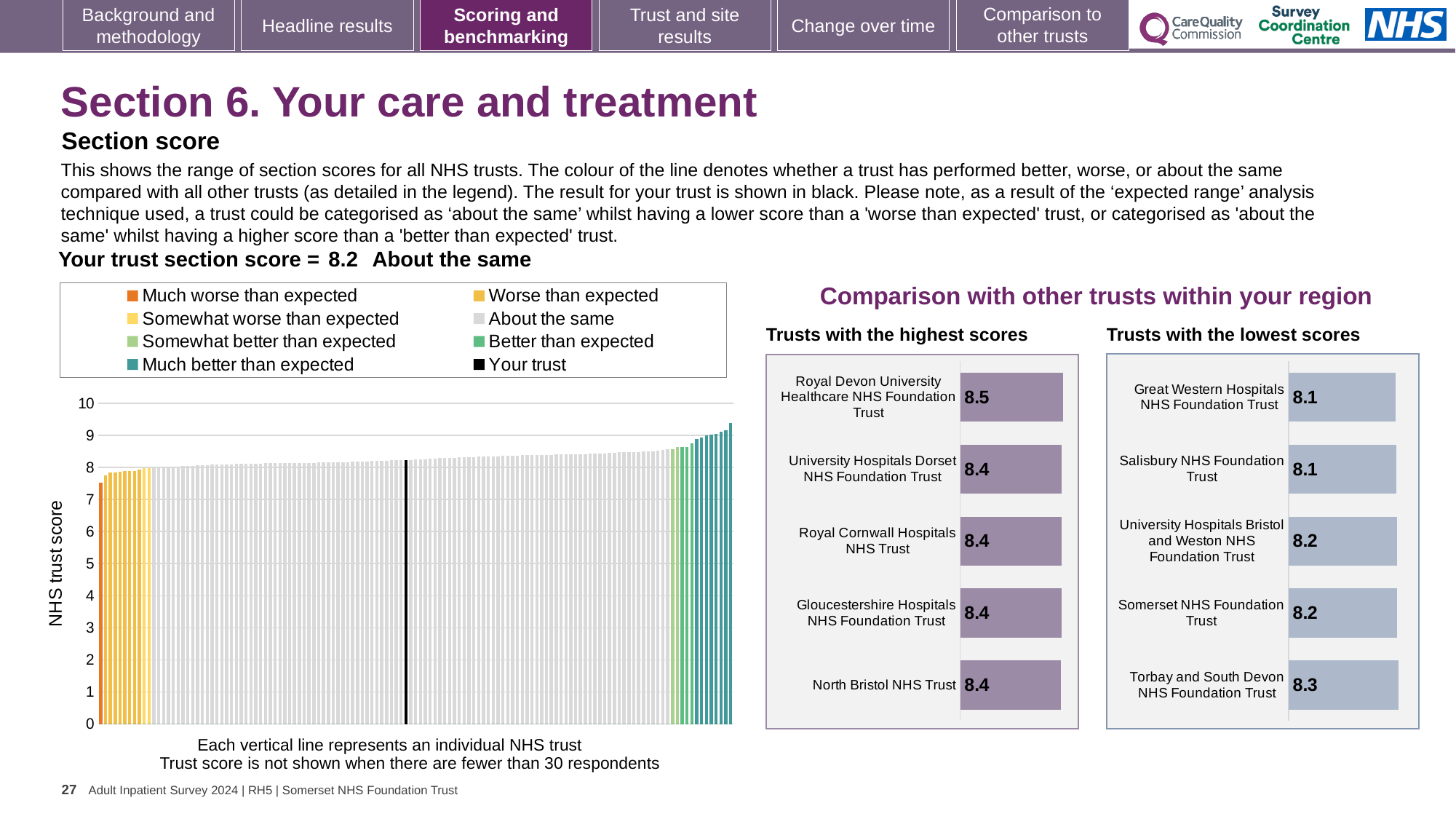
What kind of chart is the large chart on the left showing NHS trust scores? Bar chart In the 'Trusts with the lowest scores' chart, which trust has the highest score? Torbay and South Devon NHS Foundation Trust How many entries does the legend of the large chart on the left list? 8 In the 'Trusts with the lowest scores' chart, what is the score for Torbay and South Devon NHS Foundation Trust? 8.3 In the 'Trusts with the highest scores' chart, what is the difference between the scores of Royal Devon University Healthcare NHS Foundation Trust and North Bristol NHS Trust? 0.1 In the large chart on the left, is the value for the lowest-scoring trust (the leftmost bar) greater or less than 8? less In the 'Trusts with the highest scores' chart, which trust has the highest score? Royal Devon University Healthcare NHS Foundation Trust In the 'Trusts with the lowest scores' chart, what is the difference between the scores of Torbay and South Devon NHS Foundation Trust and Great Western Hospitals NHS Foundation Trust? 0.2 In the 'Trusts with the lowest scores' chart, which has the larger score: Torbay and South Devon NHS Foundation Trust or Salisbury NHS Foundation Trust? Torbay and South Devon NHS Foundation Trust In the 'Trusts with the lowest scores' chart, what is the score for Somerset NHS Foundation Trust? 8.2 How many trusts are shown in the 'Trusts with the highest scores' chart? 5 In the 'Trusts with the highest scores' chart, what is the score for Royal Devon University Healthcare NHS Foundation Trust? 8.5